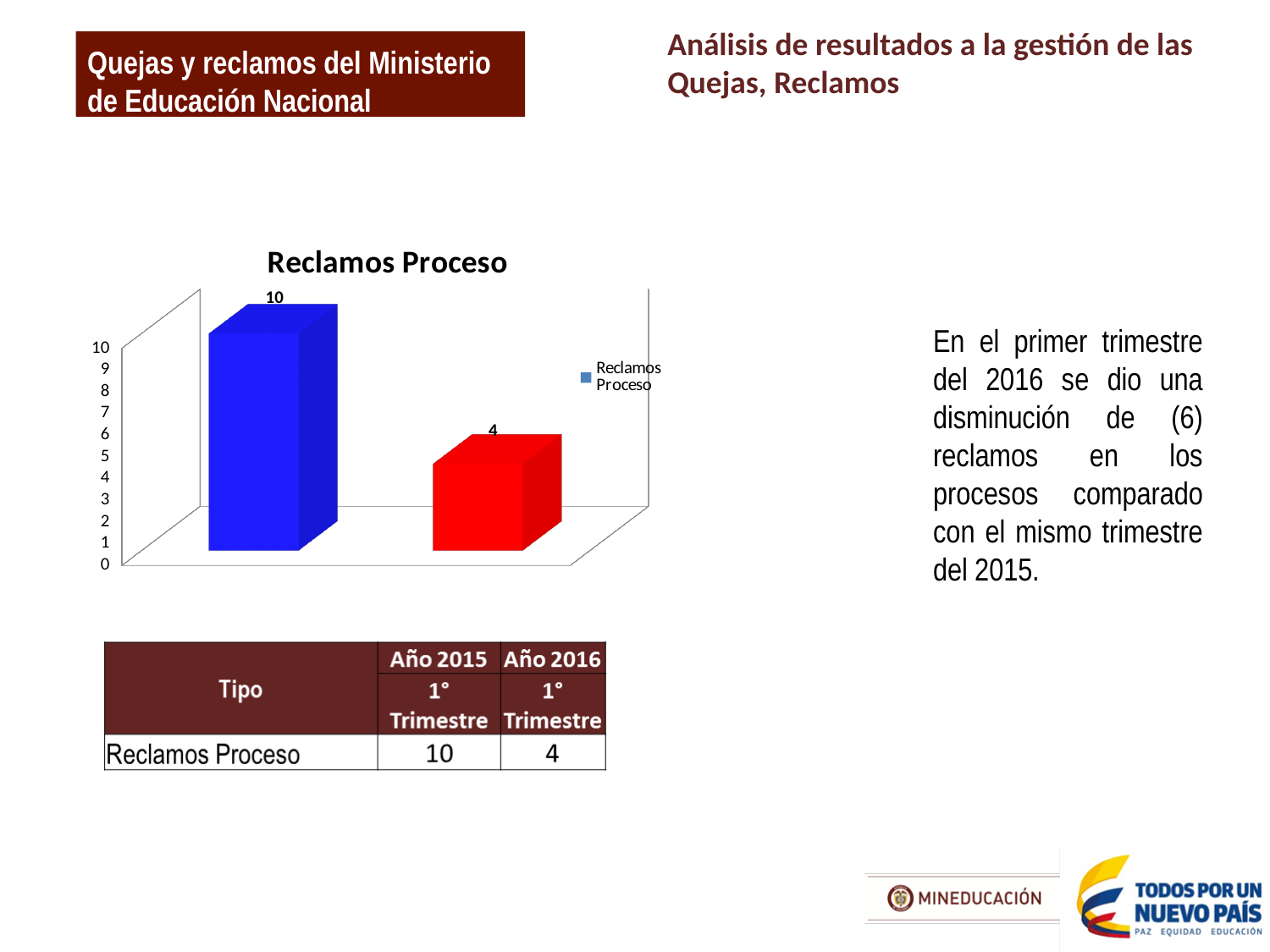
Which bar in the Reclamos Proceso chart is taller, the blue one or the red one? the blue one What value is printed on the blue bar in the Reclamos Proceso chart? 10 What value is printed on the red bar in the Reclamos Proceso chart? 4 What is the lowest value among the bars in the Reclamos Proceso chart? 4 Is the value of the red bar in the Reclamos Proceso chart greater or less than 5? less What kind of chart is shown on the slide? bar chart What is the difference between the values of the two bars in the Reclamos Proceso chart? 6 What is the title of the chart? Reclamos Proceso What is the highest value shown on the vertical axis of the Reclamos Proceso chart? 10 Do the bar values rise or fall from left to right in the Reclamos Proceso chart? fall How many series does the legend of the Reclamos Proceso chart list? 1 How many bars are plotted in the Reclamos Proceso chart? 2